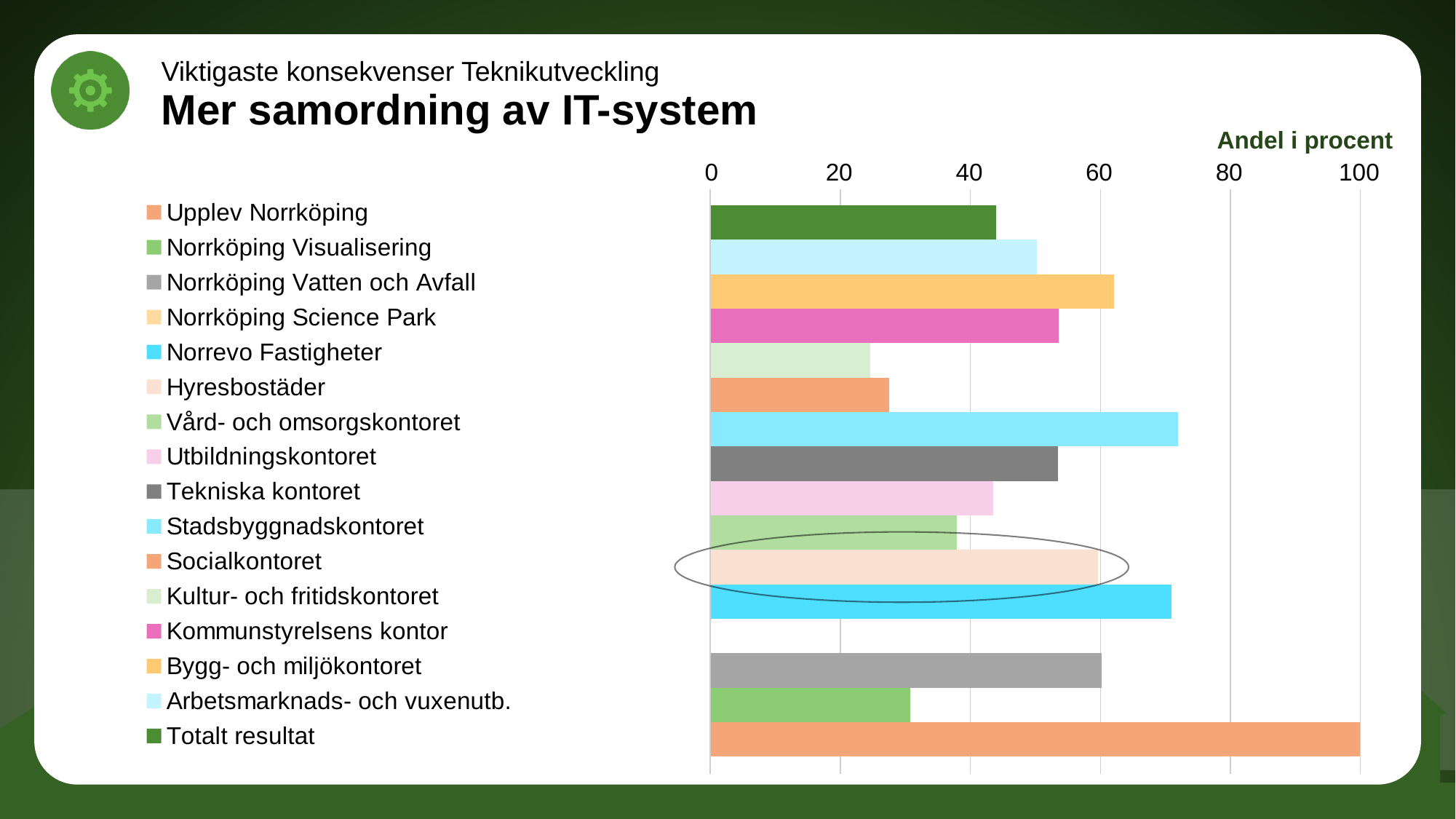
Is the value for Norrevo Fastigheter greater or less than 60? greater What is the axis title shown above the horizontal axis? Andel i procent Which is larger, the value for Norrköping Vatten och Avfall or the value for Norrköping Visualisering? Norrköping Vatten och Avfall Which is larger, the value for Stadsbyggnadskontoret or the value for Socialkontoret? Stadsbyggnadskontoret Is the value for Kultur- och fritidskontoret greater or less than 40? less Is the value for Totalt resultat greater or less than 60? less Which category has the highest value? Upplev Norrköping How many categories does the legend list? 16 What is the value for Upplev Norrköping? 100 What kind of chart is shown on the slide? bar chart